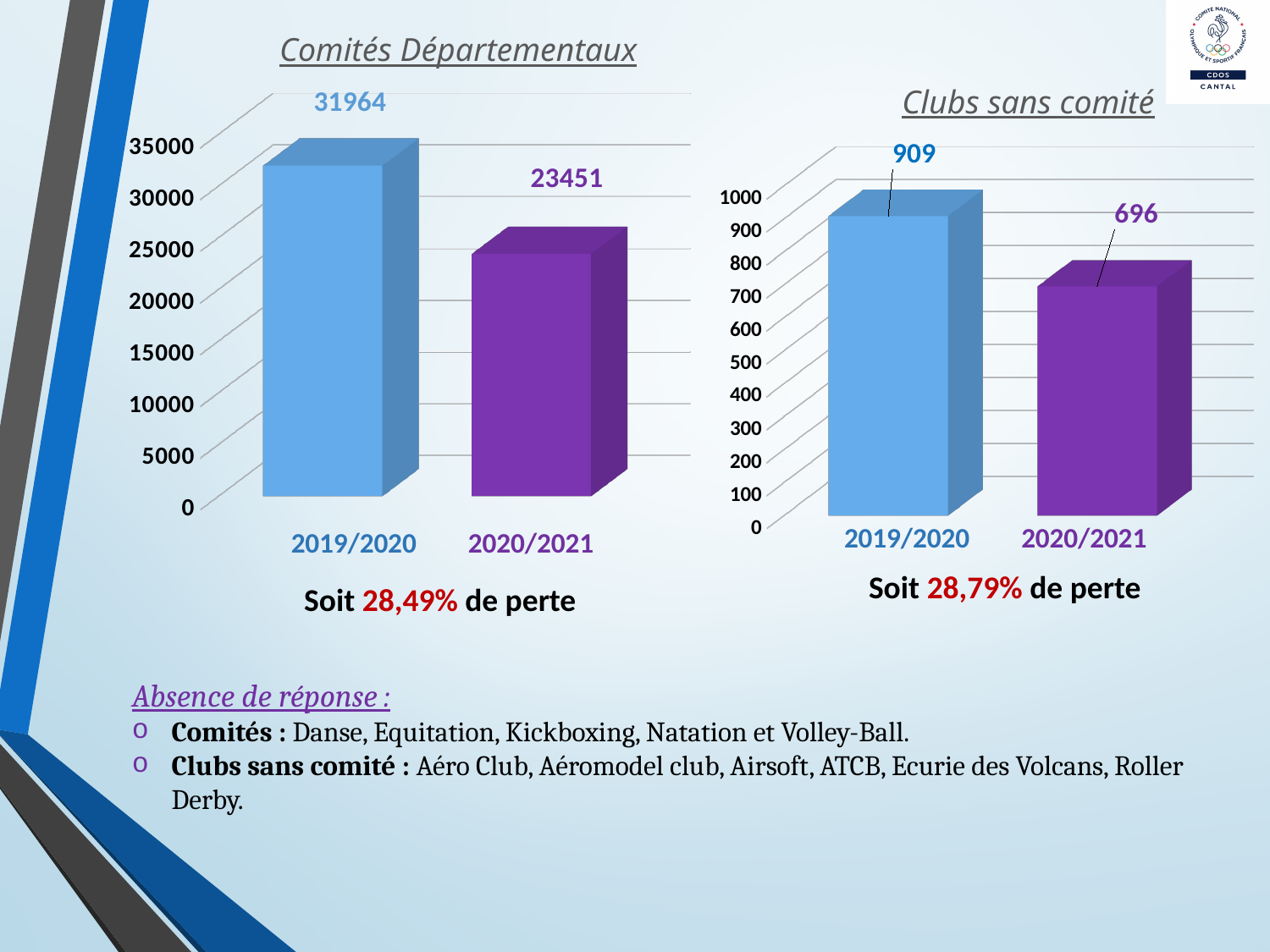
In the 'Comités Départementaux' chart, what is the value for 2019/2020? 31964 In the 'Comités Départementaux' chart, which category has the highest value? 2019/2020 In the 'Clubs sans comité' chart, which category has the lowest value? 2020/2021 In the 'Comités Départementaux' chart, what is the value for 2020/2021? 23451 In the 'Clubs sans comité' chart, what is the difference between the 2019/2020 and 2020/2021 values? 213 In the 'Comités Départementaux' chart, what is the difference between the 2019/2020 and 2020/2021 values? 8513 How many categories does the 'Comités Départementaux' chart show? 2 In the 'Clubs sans comité' chart, what is the value for 2020/2021? 696 In the 'Clubs sans comité' chart, is the value for 2020/2021 greater or less than 700? less What kind of chart is the 'Clubs sans comité' chart? bar chart In the 'Comités Départementaux' chart, do the values rise or fall from 2019/2020 to 2020/2021? fall In the 'Clubs sans comité' chart, what is the value for 2019/2020? 909